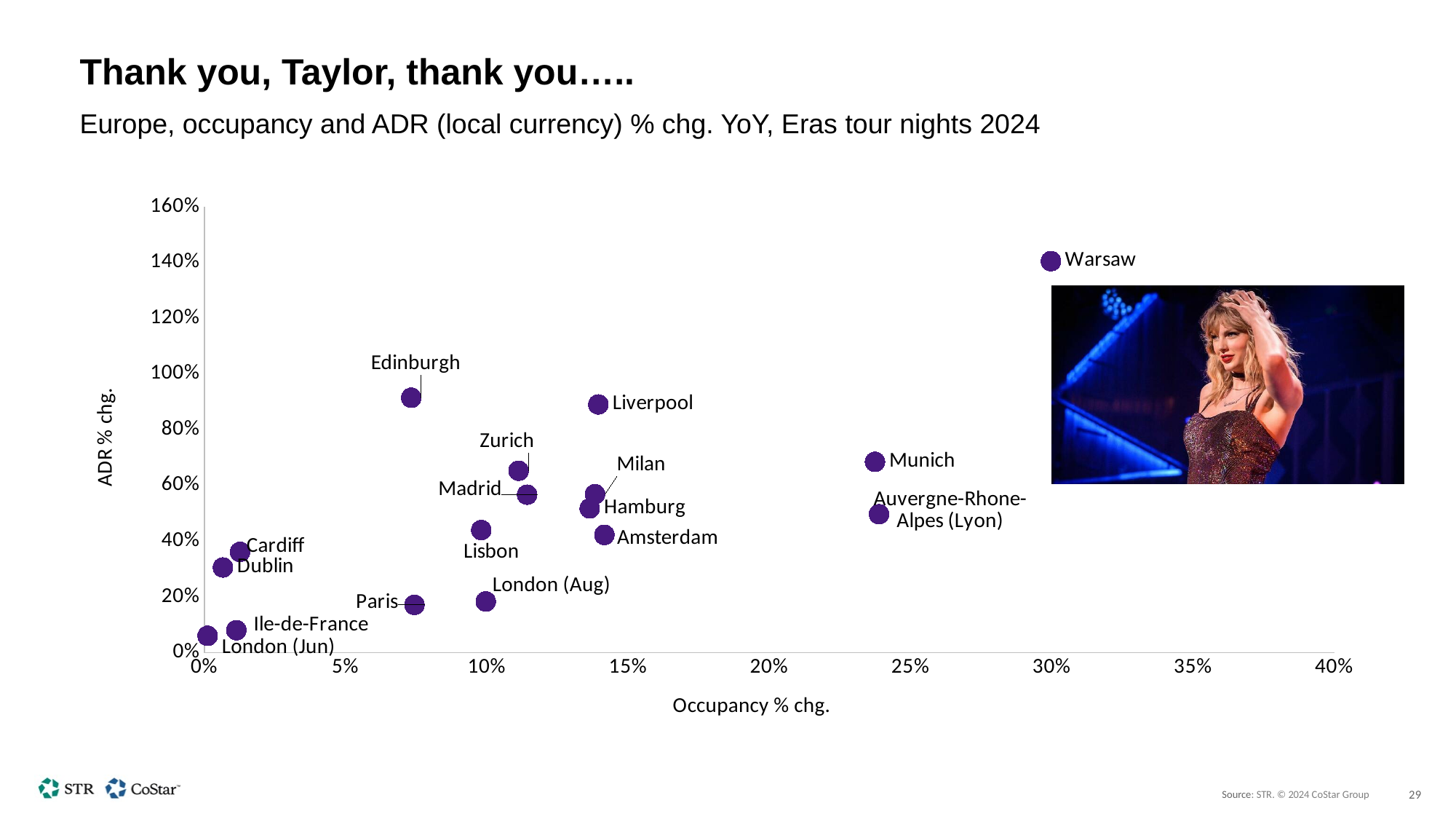
Is the ADR % change for Edinburgh greater or less than 80%? greater What is the label of the horizontal axis of the chart? Occupancy % chg. Which city has the highest ADR % change on the chart? Warsaw What kind of chart is shown on the slide? Scatter chart Is the ADR % change for Warsaw greater or less than 120%? greater Which city has the highest occupancy % change on the chart? Warsaw Is the occupancy % change for Munich greater or less than 20%? greater What is the label of the vertical axis of the chart? ADR % chg. Which point has the lowest ADR % change on the chart? London (Jun) Which has the higher ADR % change, Liverpool or Amsterdam? Liverpool How many cities or regions are plotted on the chart? 17